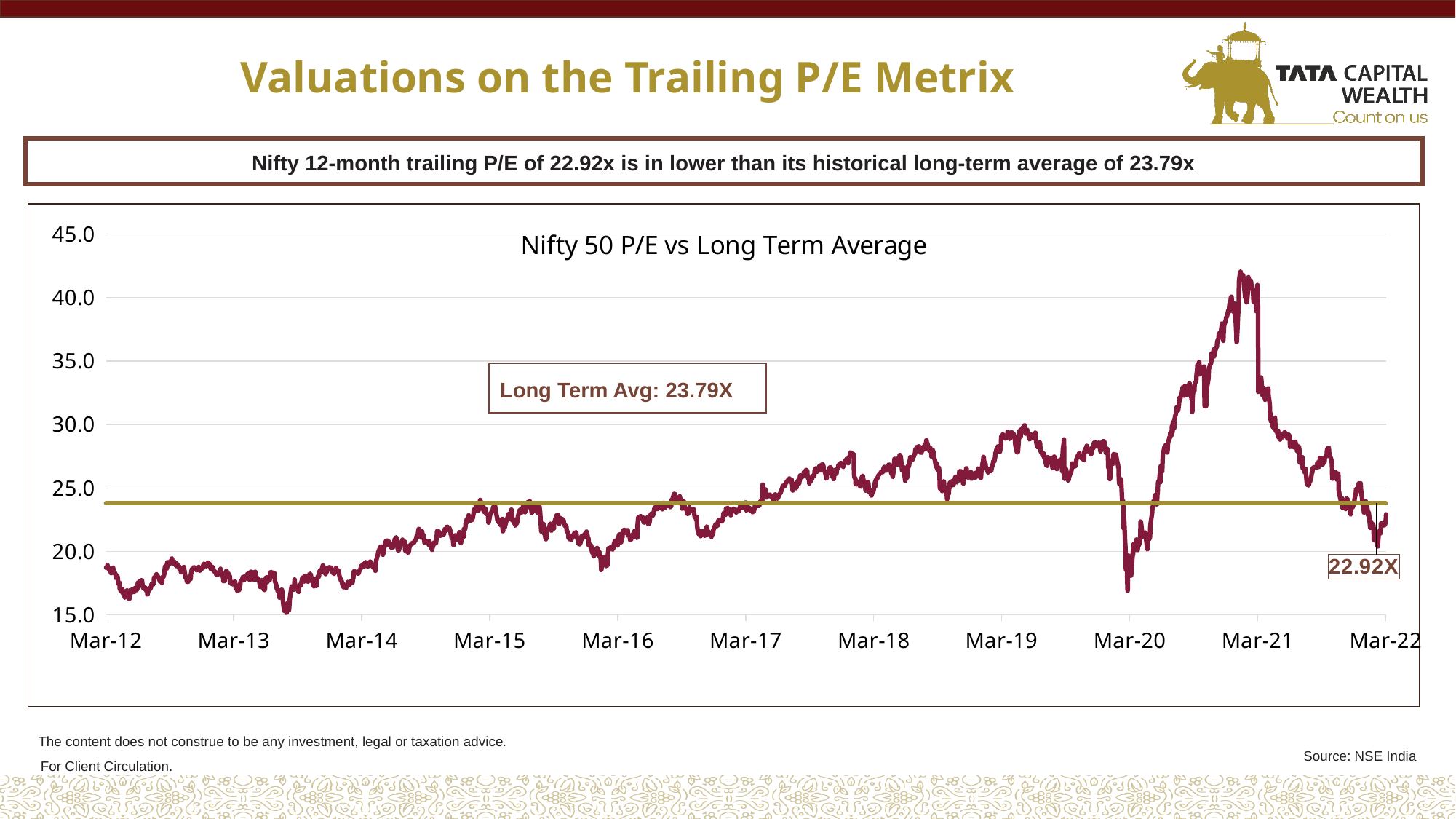
By how much is the long term average (23.79X) higher than the latest P/E (22.92X)? 0.87 How many labels are shown on the x axis? 11 What is the long term average P/E value shown on the chart? 23.79X Does the P/E line rise or fall between Mar-21 and Mar-22? Fall Is the highest point of the P/E line greater or less than 40.0? greater Around which x-axis label does the P/E line reach its highest point? Mar-21 What kind of chart is shown on the slide? Line chart What is the title of the chart? Nifty 50 P/E vs Long Term Average What is the latest P/E value labelled at the end of the line (Mar-22)? 22.92X Is the P/E value at Mar-12 greater or less than 20.0? less Which is larger: the latest P/E of 22.92X or the long term average? Long term average (23.79X)